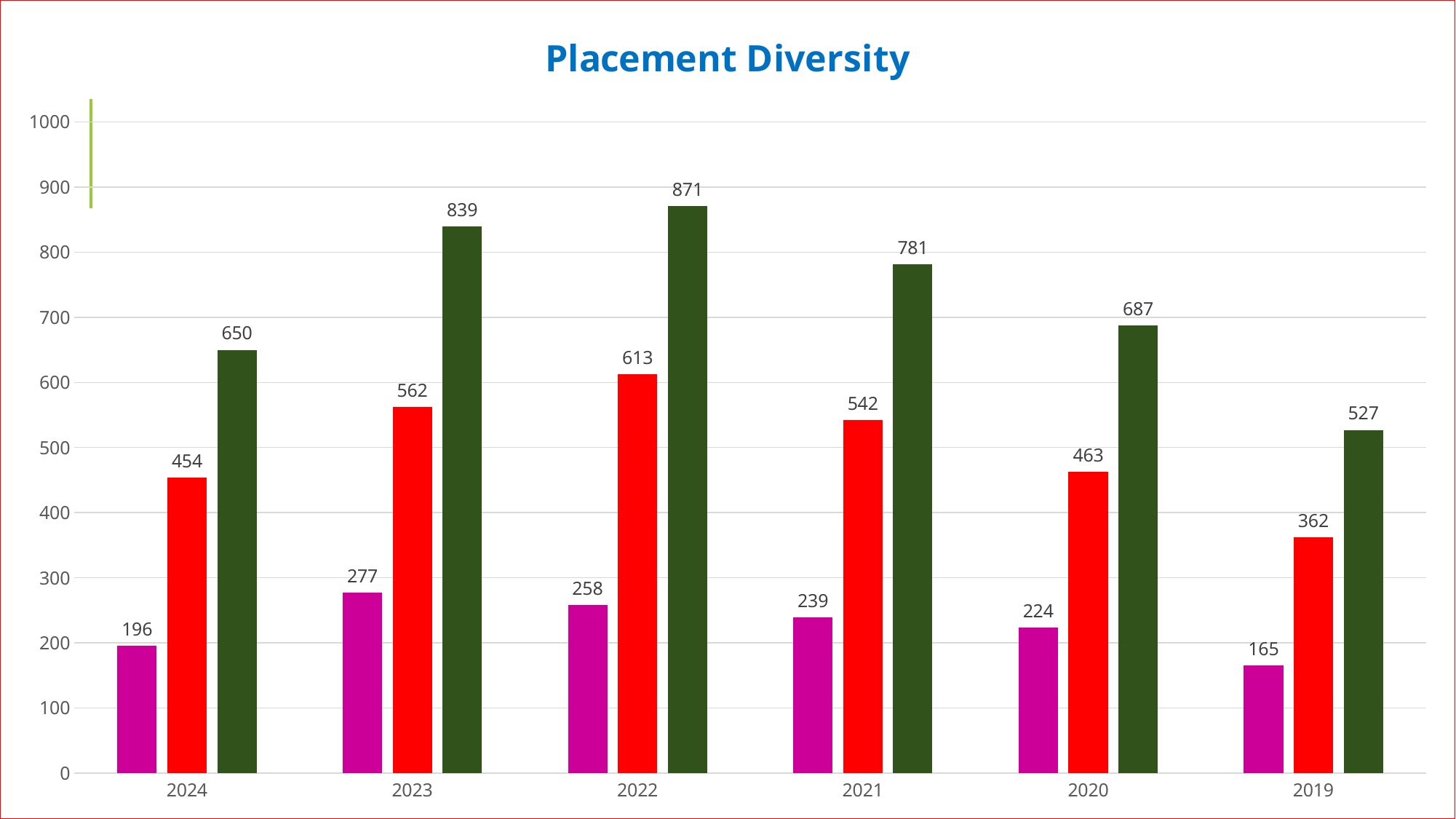
What is the value of the magenta bar for 2019? 165 Is the value of the red bar for 2024 greater or less than 500? less Which year has the highest dark green bar? 2022 What is the title of the chart? Placement Diversity How many bars are shown for each year? 3 What is the value of the dark green bar for 2022? 871 What is the value of the red bar for 2021? 542 What kind of chart is this? bar chart Which is larger for 2020: the red bar or the magenta bar? the red bar How many years are shown on the x axis? 6 What is the difference between the dark green bar and the red bar for 2023? 277 Which year has the lowest magenta bar? 2019